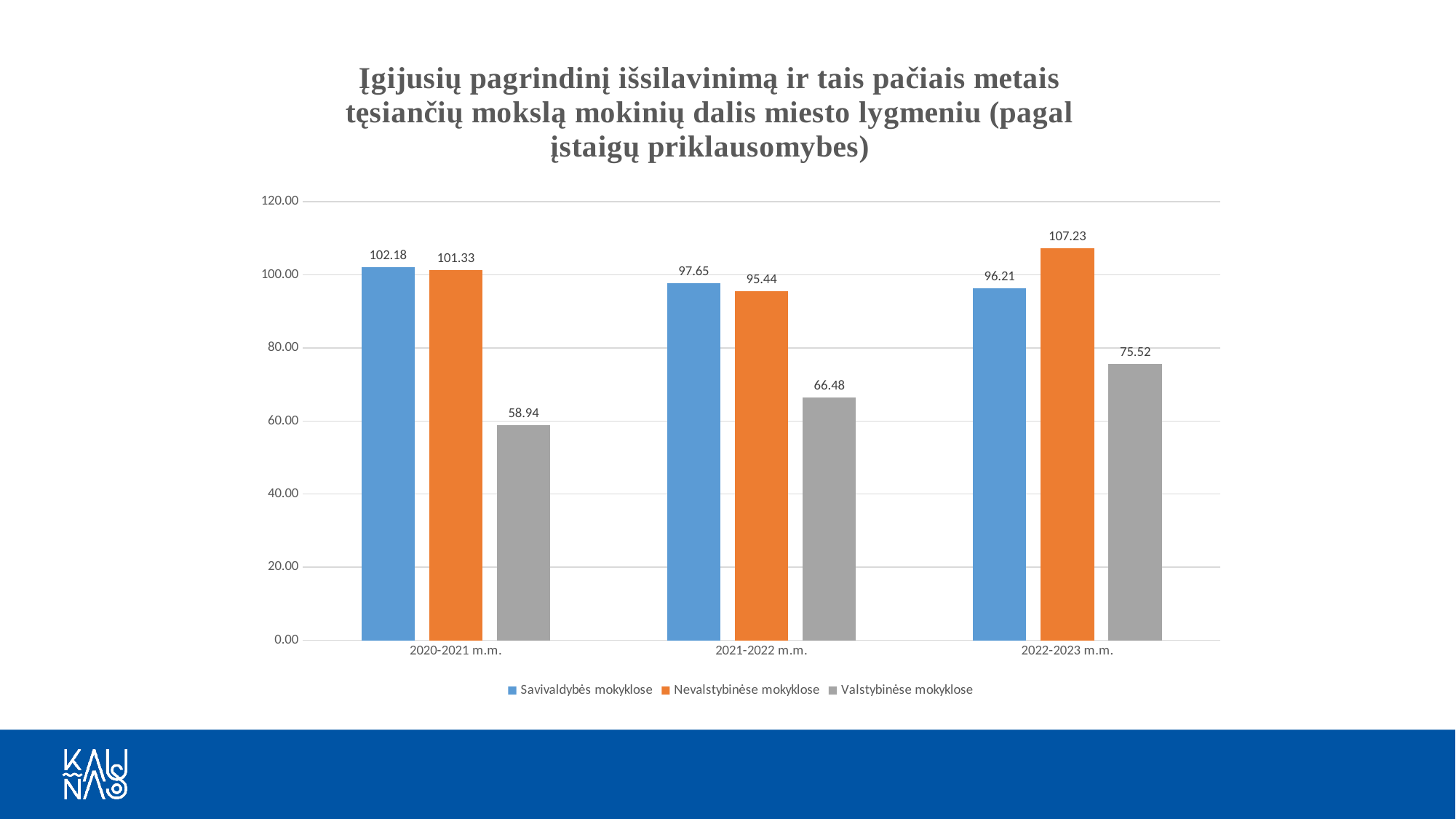
Is the value for Valstybinėse mokyklose in 2020-2021 m.m. greater or less than 60.00? less Which is larger in 2022-2023 m.m.: Savivaldybės mokyklose or Nevalstybinėse mokyklose? Nevalstybinėse mokyklose What is the value for Valstybinėse mokyklose in 2021-2022 m.m.? 66.48 How many school years are shown on the x axis? 3 How many series does the legend list? 3 Does the value for Valstybinėse mokyklose rise or fall from 2020-2021 m.m. to 2022-2023 m.m.? rise In which school year is the value for Savivaldybės mokyklose the lowest? 2022-2023 m.m. What is the value for Savivaldybės mokyklose in 2020-2021 m.m.? 102.18 What is the difference between the Nevalstybinėse mokyklose and Valstybinėse mokyklose values in 2022-2023 m.m.? 31.71 What is the value for Nevalstybinėse mokyklose in 2022-2023 m.m.? 107.23 What kind of chart is shown on the slide? bar chart In which school year is the value for Valstybinėse mokyklose the highest? 2022-2023 m.m.